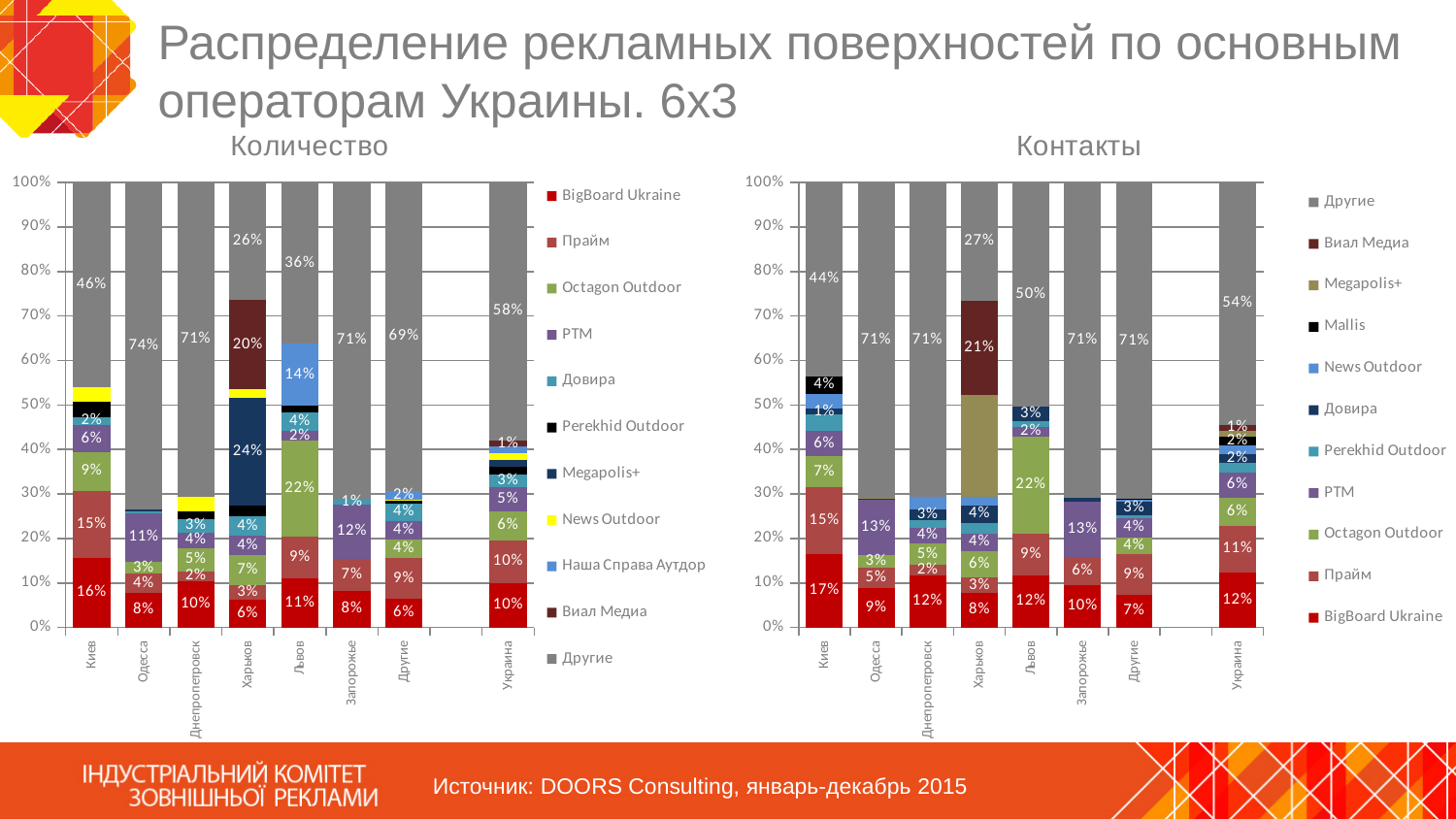
In the "Контакты" chart, which category has the largest "BigBoard Ukraine" segment? Киев In the "Контакты" chart, what is the value of the "BigBoard Ukraine" segment for Киев? 17% In the "Количество" chart, what is the value of the "Другие" segment for Киев? 46% How many categories are shown on the x axis of the "Количество" chart? 8 In the "Контакты" chart, what is the value of the "Другие" segment for Харьков? 27% What type of chart is the "Количество" chart? Stacked bar chart In the "Количество" chart, what is the difference between the "Другие" segment for Одесса and for Киев? 28% In the "Количество" chart, what is the value of the "BigBoard Ukraine" segment for Львов? 11% In the "Количество" chart, which category has the smallest "Другие" segment? Харьков How many series does the legend of the "Контакты" chart list? 11 In the "Контакты" chart, is the "BigBoard Ukraine" segment larger for Днепропетровск or for Другие? Днепропетровск In the "Количество" chart, which category has the largest "Другие" segment? Одесса